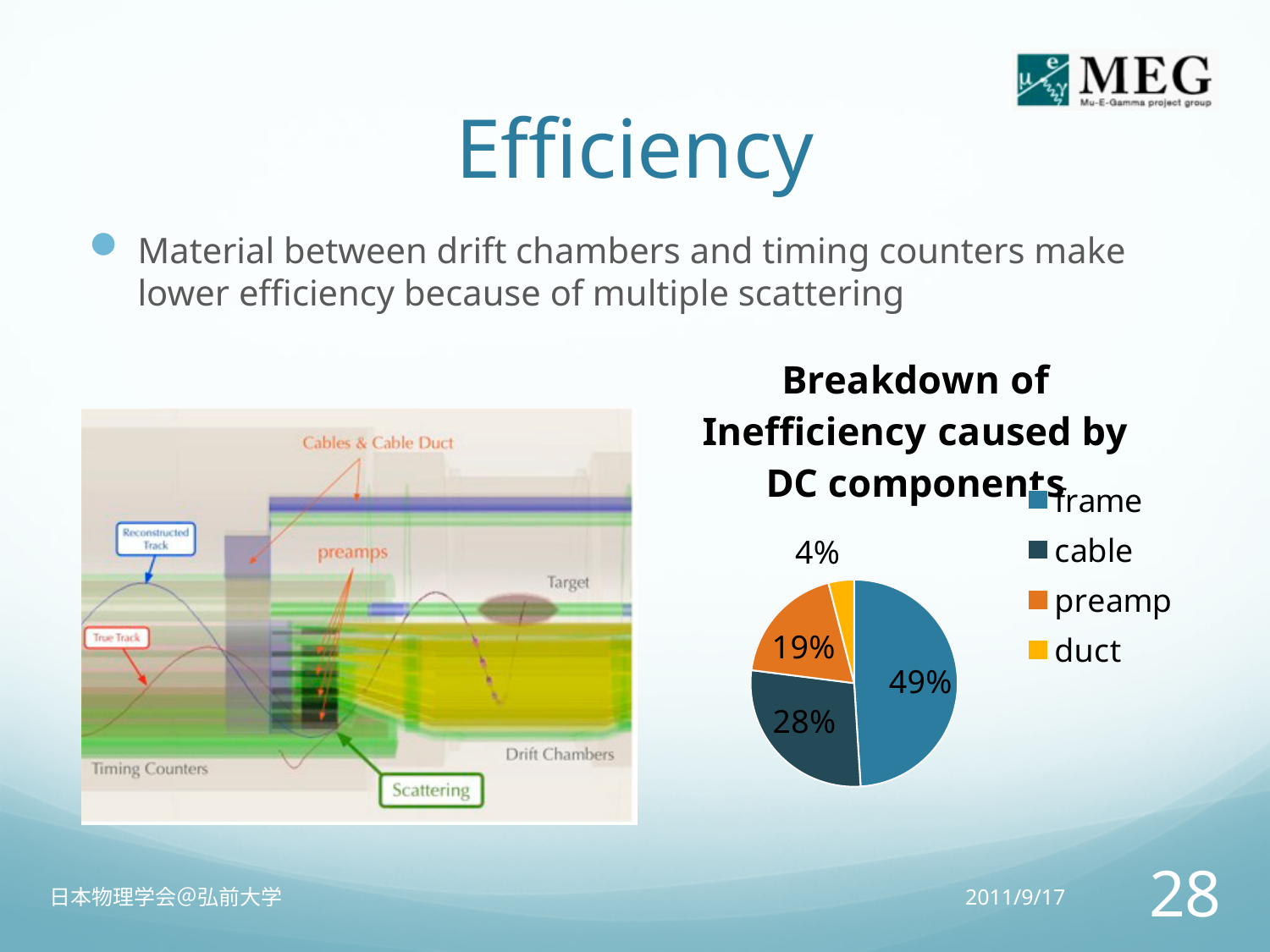
What share of the pie does cable account for? 28% What share of the pie does frame account for? 49% What is the title of the pie chart? Breakdown of Inefficiency caused by DC components How many entries does the legend list? 4 Which has a larger share, cable or preamp? cable What type of chart is shown on the slide? pie chart What share of the pie does duct account for? 4% Which component has the largest share of the pie? frame Which component has the smallest share of the pie? duct What share of the pie does preamp account for? 19% How many slices does the pie chart have? 4 What is the difference in percentage points between the frame and cable shares? 21